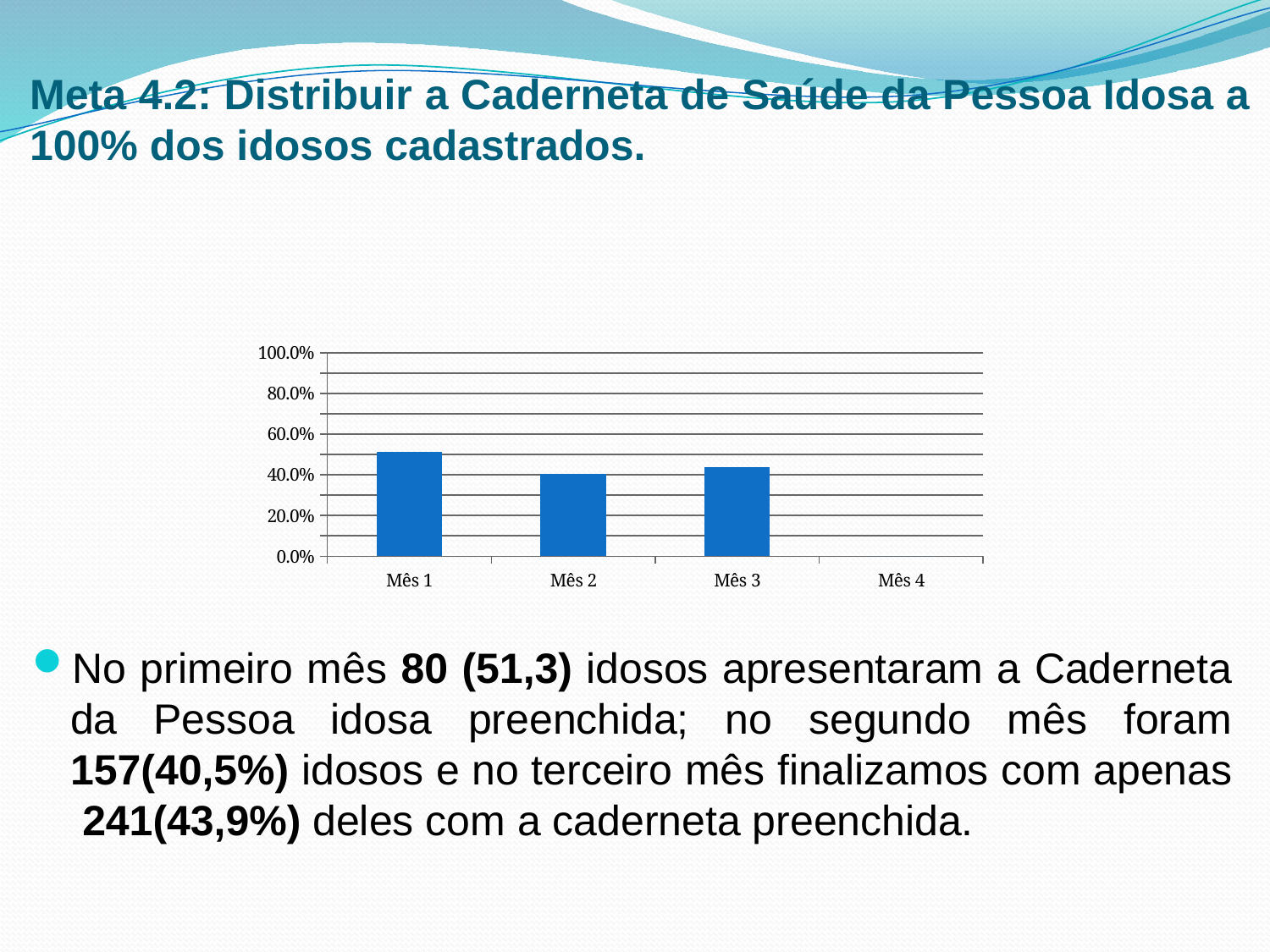
What is the highest value shown on the y axis of the chart? 100.0% Is the value for Mês 2 greater or less than 60.0%? less Is the value for Mês 1 greater or less than 40.0%? greater Which month has the highest bar in the chart? Mês 1 Which of the months with a visible bar has the lowest value? Mês 2 Does the value rise or fall from Mês 1 to Mês 2? fall How many categories are labelled on the x axis of the chart? 4 Is the value for Mês 1 greater or less than 60.0%? less Which is larger, the value for Mês 2 or the value for Mês 3? Mês 3 Which month on the x axis has no visible bar? Mês 4 What kind of chart is shown on the slide? bar chart